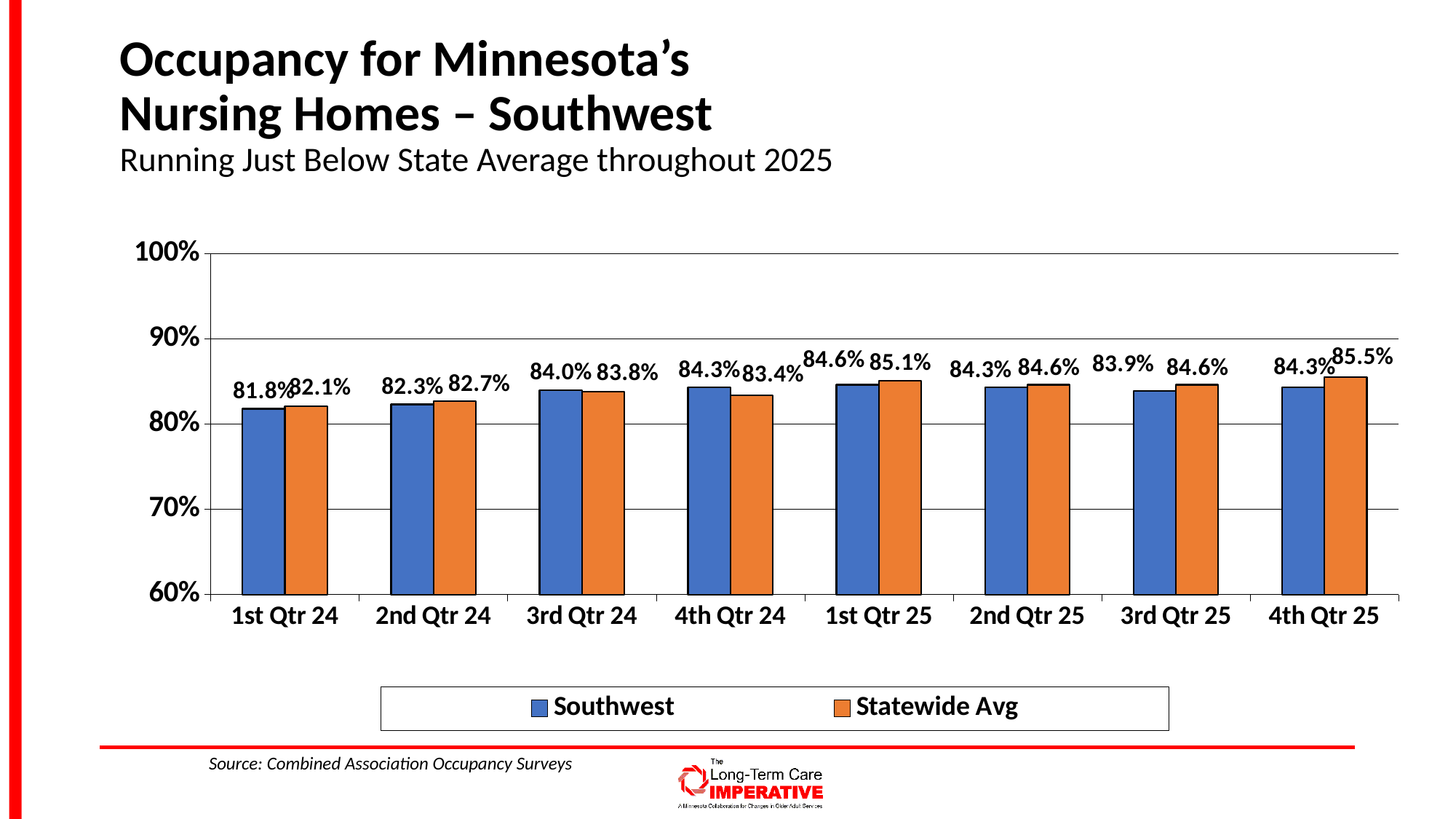
What kind of chart is shown on the slide? bar chart Which colour represents the Statewide Avg series? orange In which quarter is the Southwest occupancy lowest? 1st Qtr 24 In 4th Qtr 24, which is larger: the Southwest value or the Statewide Avg value? Southwest What is the Statewide Avg occupancy value for 4th Qtr 25? 85.5% How many quarters are shown on the x axis? 8 In which quarter is the Statewide Avg occupancy highest? 4th Qtr 25 What is the Southwest occupancy value for 3rd Qtr 25? 83.9% Is the Southwest value for 2nd Qtr 24 greater or less than 90%? less How many series does the legend list? 2 What is the difference between the Statewide Avg and Southwest values in 4th Qtr 25? 1.2% What is the Southwest occupancy value for 1st Qtr 25? 84.6%